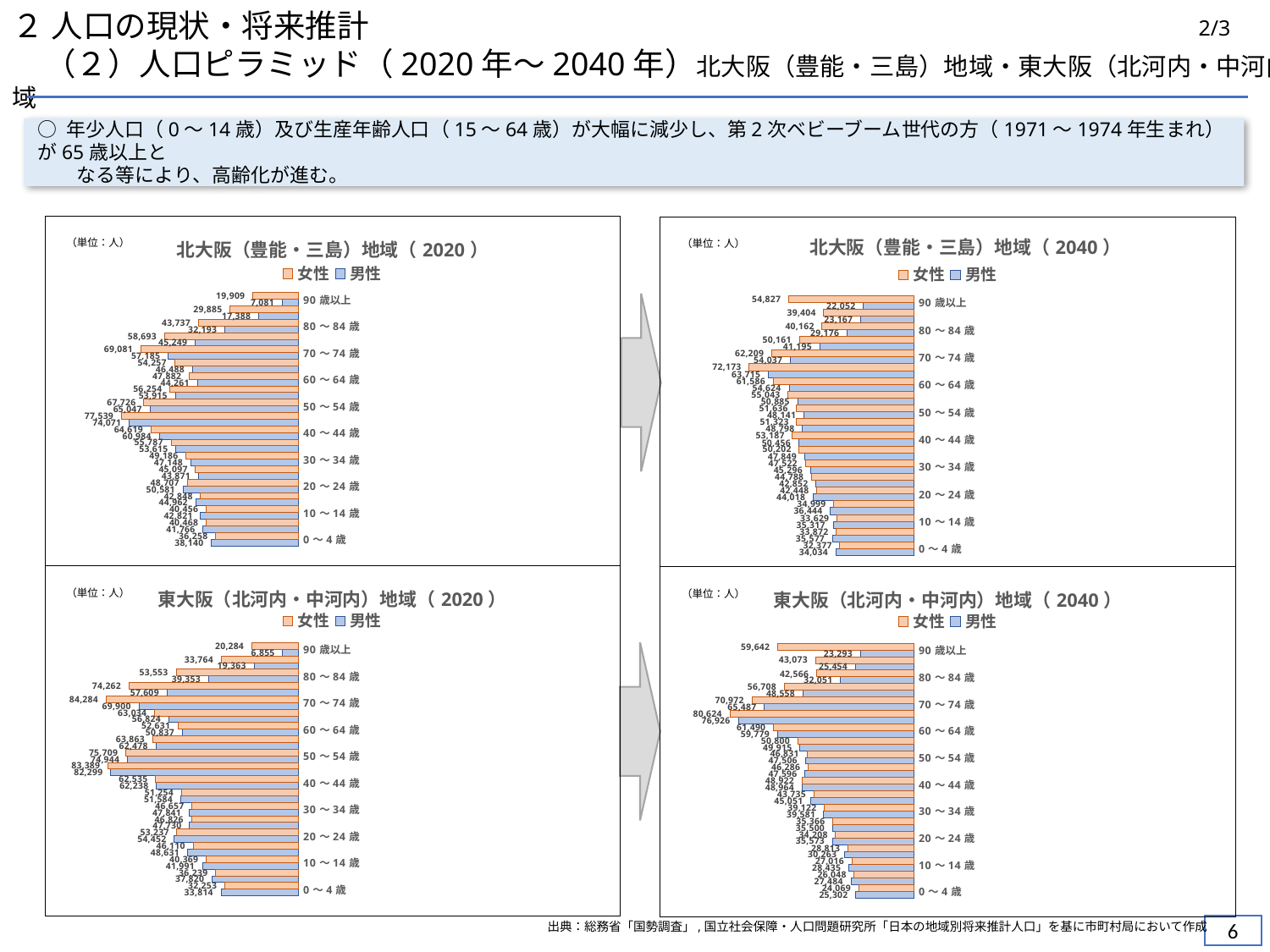
In the 北大阪（豊能・三島）地域（2020） chart, what is the difference between the 女性 and 男性 values in the 90歳以上 group? 12,828 What kind of chart is the 東大阪（北河内・中河内）地域（2020） chart? bar chart In the 東大阪（北河内・中河内）地域（2020） chart, which age group has the highest 女性 value? 70～74歳 In the 東大阪（北河内・中河内）地域（2040） chart, what is the value for 男性 in the 0～4歳 group? 25,302 How many series does the legend of the 北大阪（豊能・三島）地域（2040） chart list? 2 In the 東大阪（北河内・中河内）地域（2020） chart, what is the value for 男性 in the 90歳以上 group? 6,855 In the 東大阪（北河内・中河内）地域（2040） chart, which is larger in the 90歳以上 group, 女性 or 男性? 女性 In the 東大阪（北河内・中河内）地域（2040） chart, what is the value for 女性 in the 90歳以上 group? 59,642 In the 北大阪（豊能・三島）地域（2040） chart, what is the value for 男性 in the 0～4歳 group? 34,034 In the 北大阪（豊能・三島）地域（2020） chart, what is the value for 男性 in the 0～4歳 group? 38,140 In the 北大阪（豊能・三島）地域（2020） chart, what is the value for 女性 in the 90歳以上 group? 19,909 In the 北大阪（豊能・三島）地域（2040） chart, what is the value for 女性 in the 90歳以上 group? 54,827